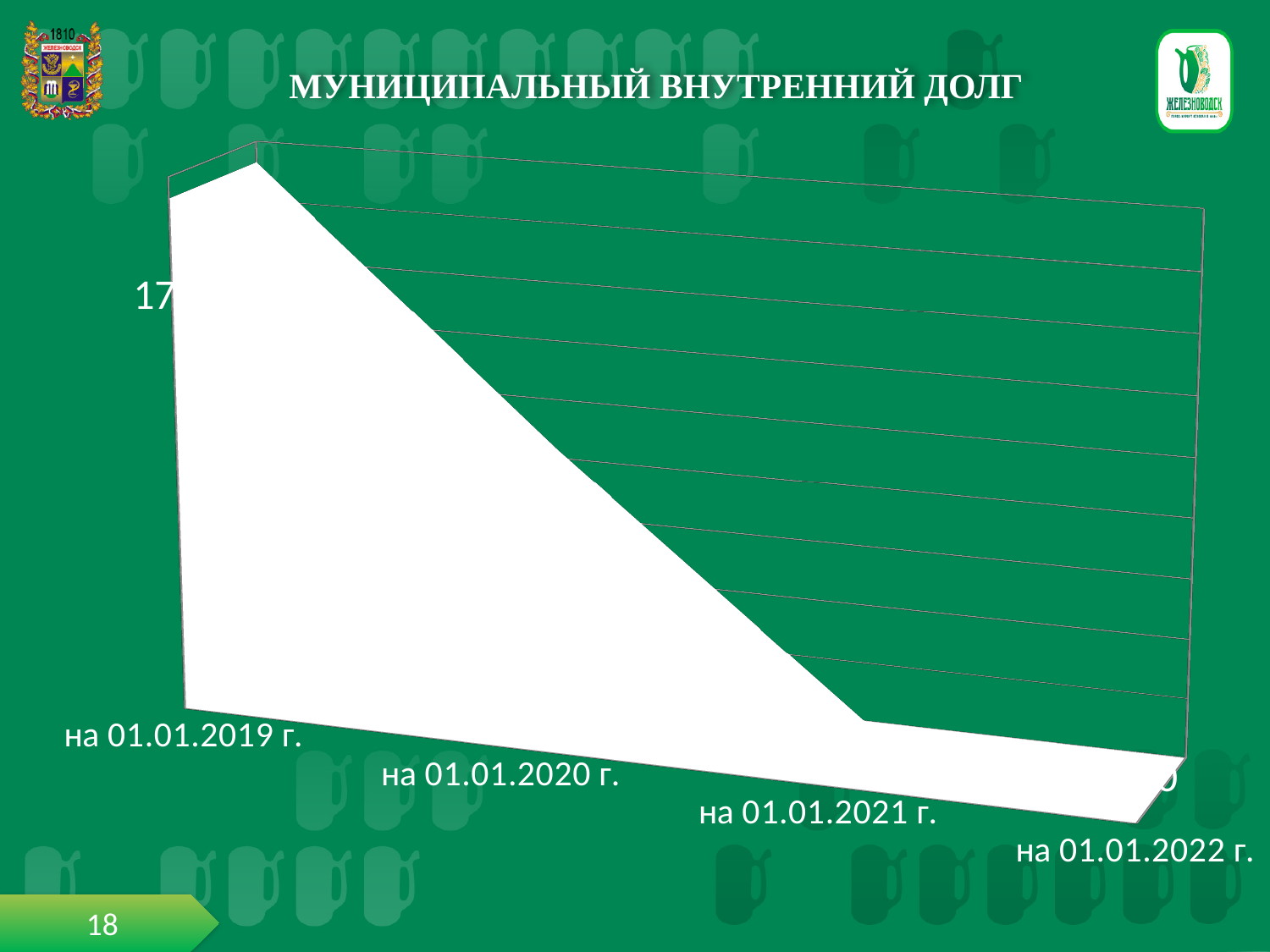
What is the first date label on the x axis? на 01.01.2019 г. Do the values rise or fall from 01.01.2019 to 01.01.2022? fall What is the value shown for на 01.01.2022 г.? 0 What is the title of the chart? МУНИЦИПАЛЬНЫЙ ВНУТРЕННИЙ ДОЛГ Which date has the highest value of municipal internal debt? на 01.01.2019 г. Which is larger, the value for на 01.01.2020 г. or the value for на 01.01.2021 г.? на 01.01.2020 г. Which is larger, the value for на 01.01.2019 г. or the value for на 01.01.2020 г.? на 01.01.2019 г. What kind of chart is shown on the slide? area chart How many dates (categories) are plotted along the x axis? 4